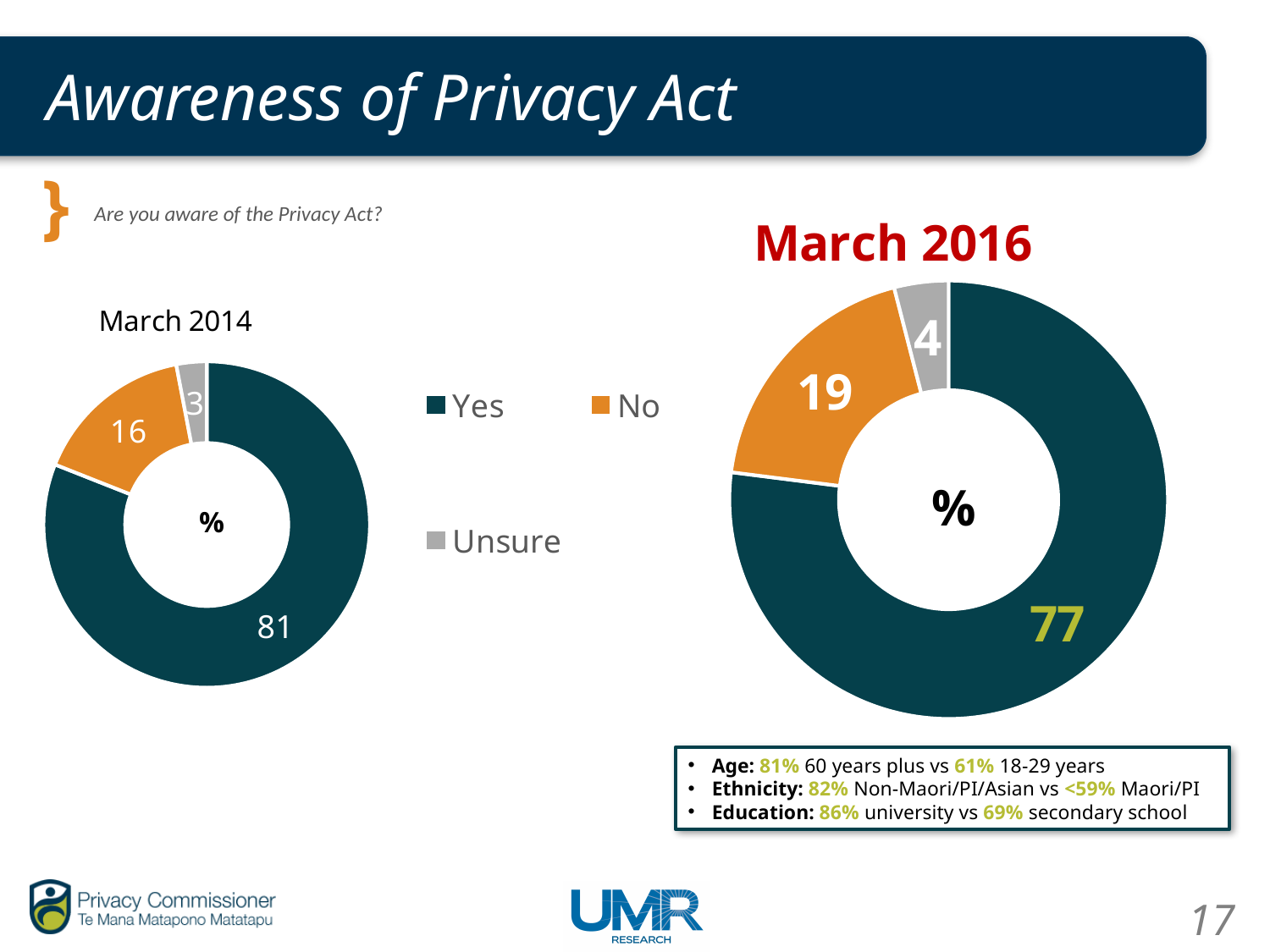
What colour represents Unsure in the charts? Grey How many entries does the shared legend list? 3 In the March 2016 chart, what is the value for No? 19 Is the No value larger in the March 2014 chart or the March 2016 chart? March 2016 In the March 2014 chart, which category has the smallest share? Unsure In the March 2016 chart, which category has the largest share? Yes How many categories does the March 2016 chart show? 3 In the March 2014 chart, what is the value for Yes? 81 What kind of chart is the March 2014 chart? Doughnut chart In the March 2014 chart, what is the value for No? 16 In the March 2016 chart, what is the value for Unsure? 4 What is the difference between the Yes value in the March 2014 chart and the Yes value in the March 2016 chart? 4